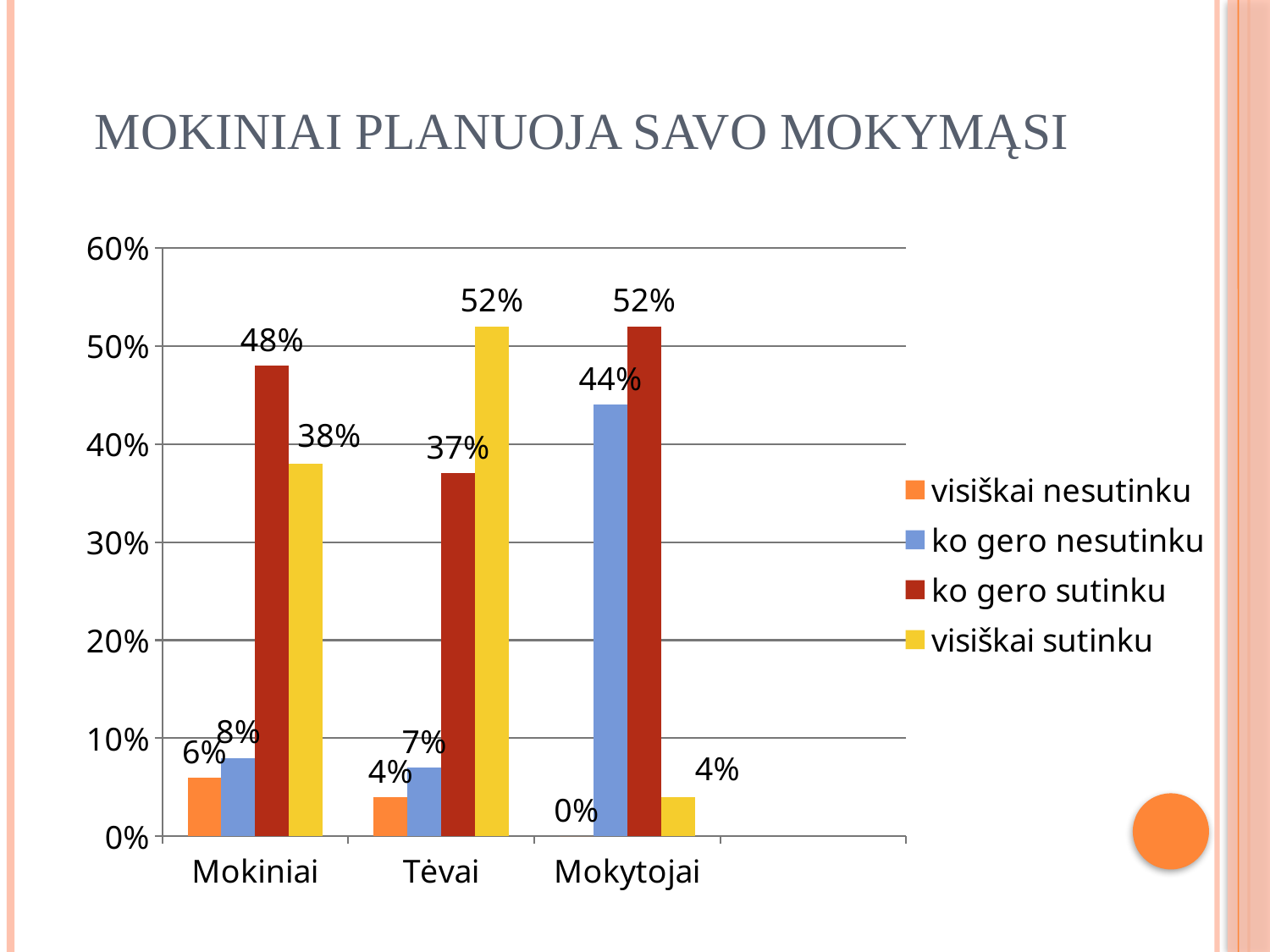
What is the value for "visiškai sutinku" in the Tėvai category? 52% What is the title of the slide? MOKINIAI PLANUOJA SAVO MOKYMĄSI What is the difference between "ko gero sutinku" and "visiškai sutinku" in the Mokiniai category? 10% Which category has the highest value for "visiškai sutinku"? Tėvai What is the value for "visiškai nesutinku" in the Mokytojai category? 0% How many categories are shown on the x axis? 3 Which category has the lowest value for "ko gero nesutinku"? Tėvai What is the value for "ko gero nesutinku" in the Mokytojai category? 44% How many series does the legend list? 4 What is the value for "ko gero sutinku" in the Mokiniai category? 48% Which is larger in the Tėvai category: "ko gero sutinku" or "visiškai sutinku"? visiškai sutinku What kind of chart is shown on the slide? Bar chart